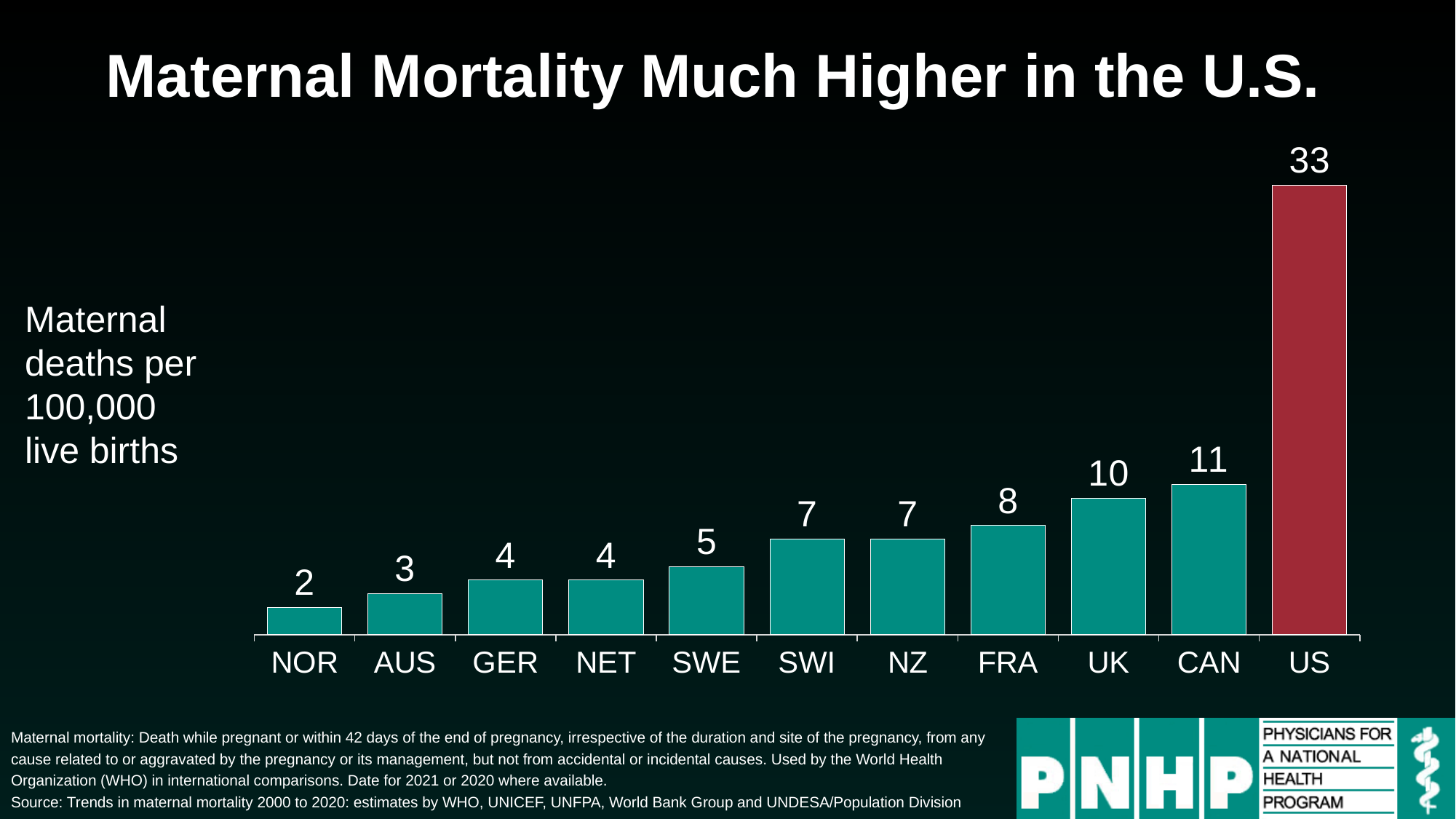
Which bar is shown in a different colour (red) from the others? US What is the maternal mortality value for NOR? 2 What is the difference between the UK value and the AUS value? 7 Which country has the lowest maternal mortality on the chart? NOR How many countries are shown on the chart? 11 Which country has the highest maternal mortality on the chart? US Which has a higher maternal mortality value, FRA or SWE? FRA What is the maternal mortality value for CAN? 11 Do the values generally rise or fall from left to right along the x axis? Rise What is the maternal mortality value for the US? 33 What kind of chart is shown on the slide? Bar chart What is the difference between the US value and the CAN value? 22